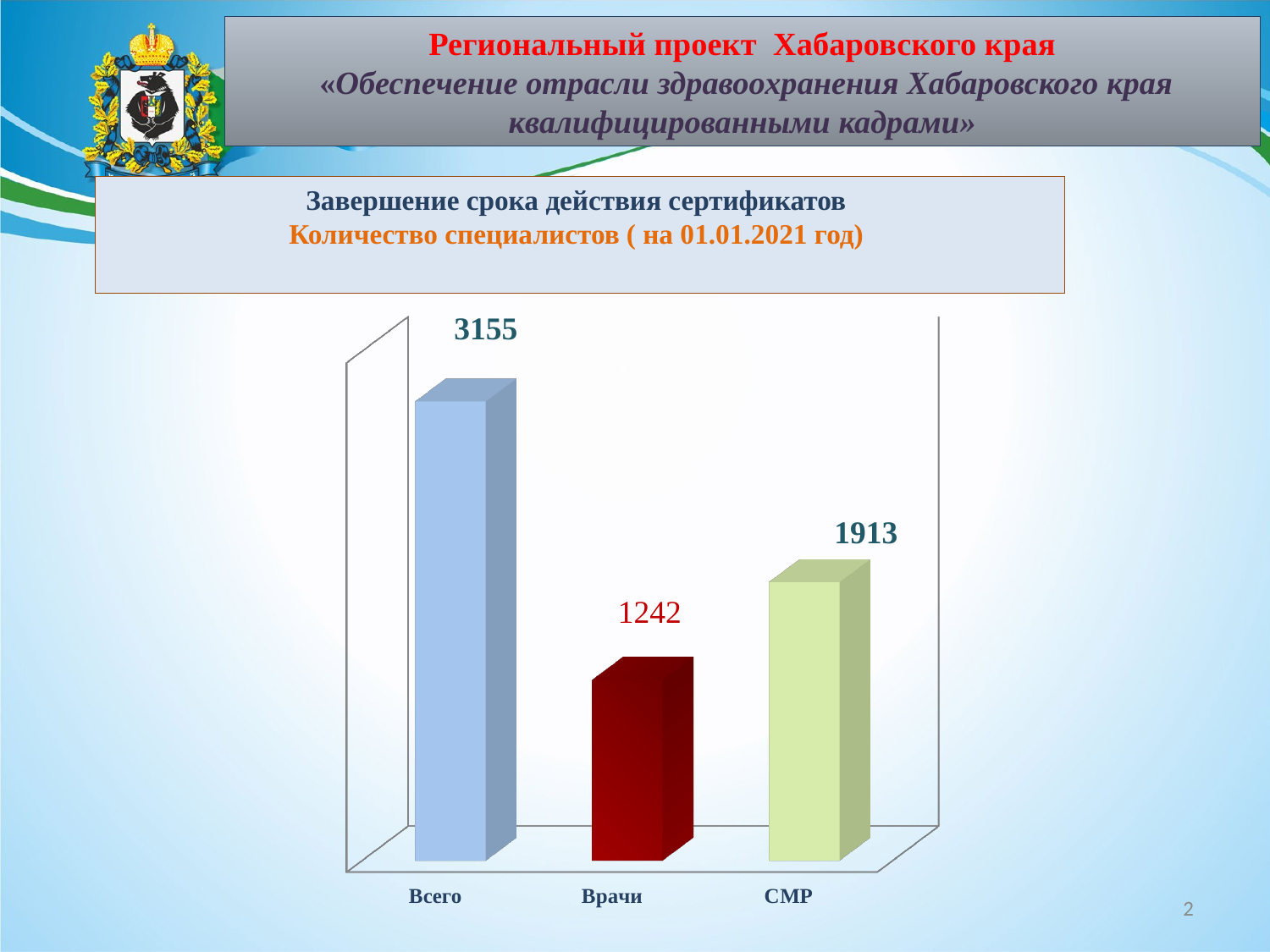
What kind of chart is shown on the slide? bar chart What is the value for Всего? 3155 Which category has the lowest value? Врачи What date is given in the chart heading for the number of specialists? 01.01.2021 What is the value for СМР? 1913 What is the difference between the values for СМР and Врачи? 671 Which is larger, the value for Врачи or the value for СМР? СМР Which category has the highest value? Всего What colour is the bar for Врачи? dark red What is the value for Врачи? 1242 What is the difference between the values for Всего and СМР? 1242 How many categories are shown on the chart? 3